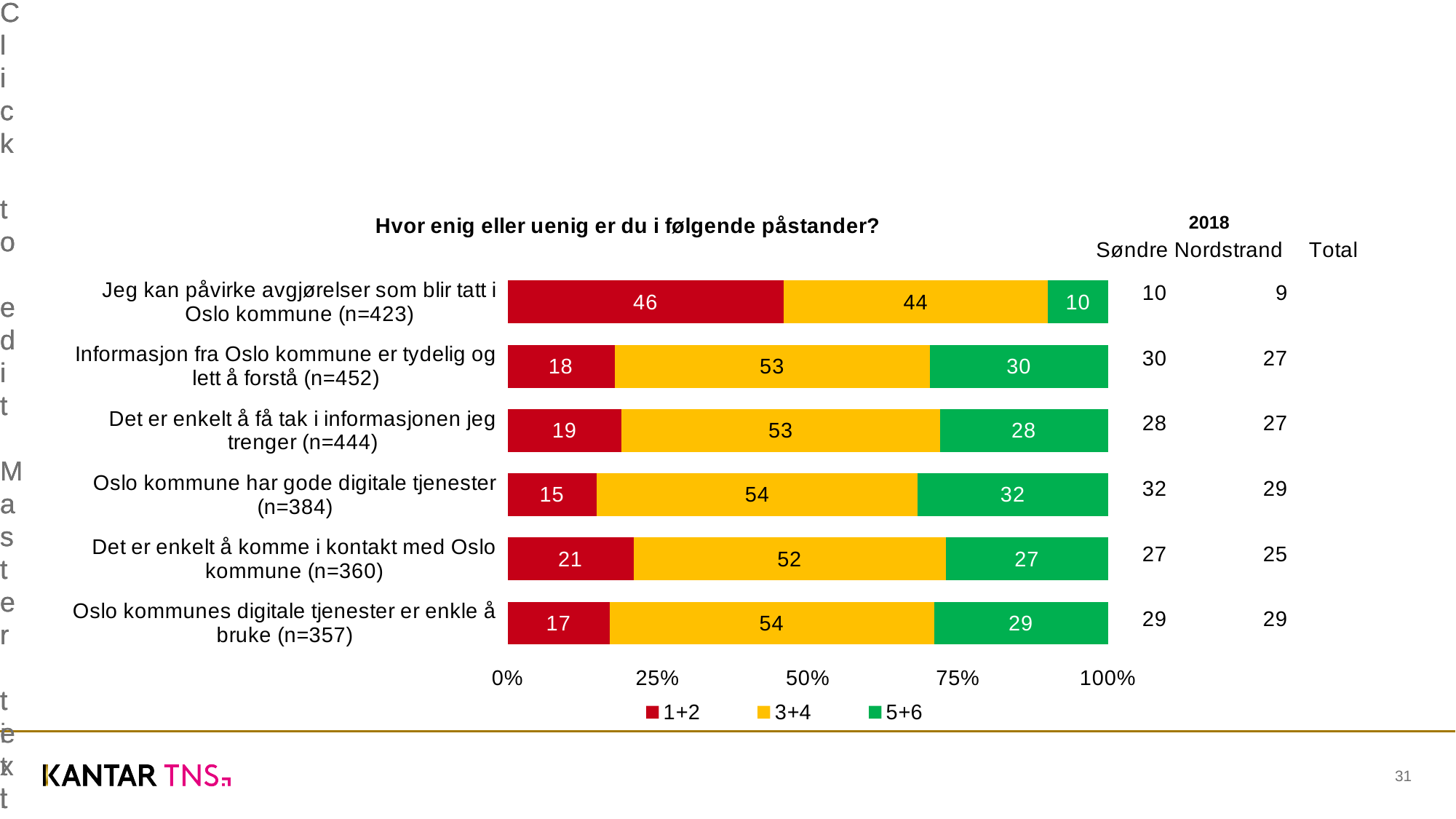
What is the value of the 3+4 series for "Det er enkelt å komme i kontakt med Oslo kommune (n=360)"? 52 What is the value of the 1+2 series for "Jeg kan påvirke avgjørelser som blir tatt i Oslo kommune (n=423)"? 46 What is the title of the chart? Hvor enig eller uenig er du i følgende påstander? Which is larger: the 5+6 value for "Oslo kommune har gode digitale tjenester (n=384)" or the 5+6 value for "Det er enkelt å komme i kontakt med Oslo kommune (n=360)"? Oslo kommune har gode digitale tjenester (n=384) What is the difference between the 3+4 value and the 1+2 value for "Informasjon fra Oslo kommune er tydelig og lett å forstå (n=452)"? 35 How many categories (statements) are shown in the chart? 6 Which category has the lowest value for the 5+6 series? Jeg kan påvirke avgjørelser som blir tatt i Oslo kommune (n=423) What is the value of the 5+6 series for "Oslo kommune har gode digitale tjenester (n=384)"? 32 How many series does the legend list? 3 What is the total of the stacked bar for "Oslo kommunes digitale tjenester er enkle å bruke (n=357)"? 100 What kind of chart is shown on the slide? Stacked bar chart Which category has the highest value for the 1+2 series? Jeg kan påvirke avgjørelser som blir tatt i Oslo kommune (n=423)